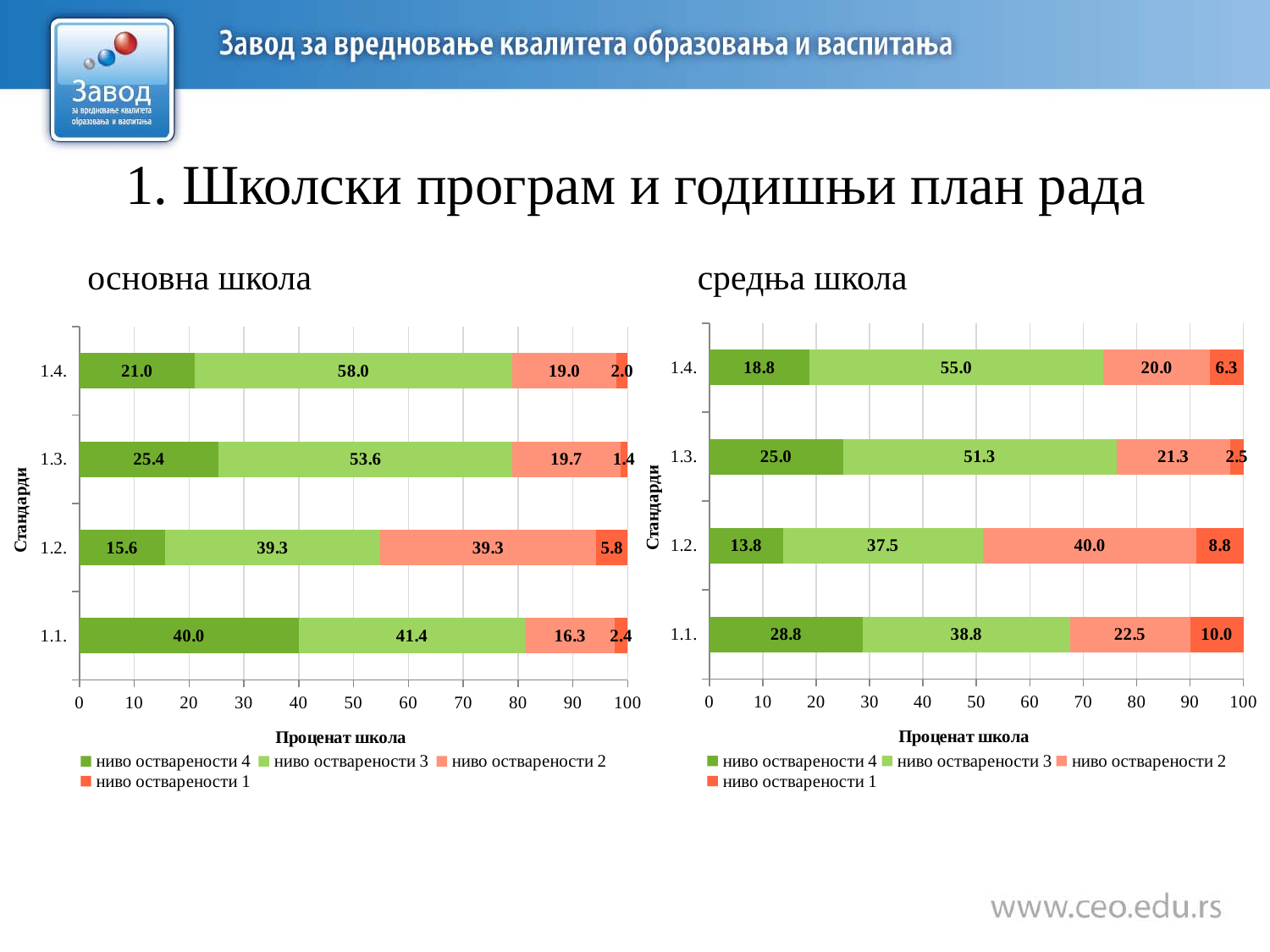
In the 'средња школа' chart, what is the value of 'ниво остварености 2' for standard 1.2.? 40.0 How many standards (categories) are shown in the 'средња школа' chart? 4 In the 'основна школа' chart, what is the value of 'ниво остварености 3' for standard 1.4.? 58.0 What type of chart is the 'средња школа' chart? Stacked bar chart In the 'средња школа' chart, which is larger for standard 1.4.: 'ниво остварености 2' or 'ниво остварености 1'? ниво остварености 2 In the 'основна школа' chart, what is the difference between 'ниво остварености 3' and 'ниво остварености 4' for standard 1.3.? 28.2 In the 'основна школа' chart, what is the total of the stacked bar for standard 1.4.? 100.0 In the 'средња школа' chart, what is the value of 'ниво остварености 1' for standard 1.1.? 10.0 How many series does the legend of the 'основна школа' chart list? 4 In the 'основна школа' chart, what is the value of 'ниво остварености 4' for standard 1.1.? 40.0 In the 'средња школа' chart, which standard has the lowest value for 'ниво остварености 4'? 1.2. In the 'основна школа' chart, which standard has the highest value for 'ниво остварености 4'? 1.1.